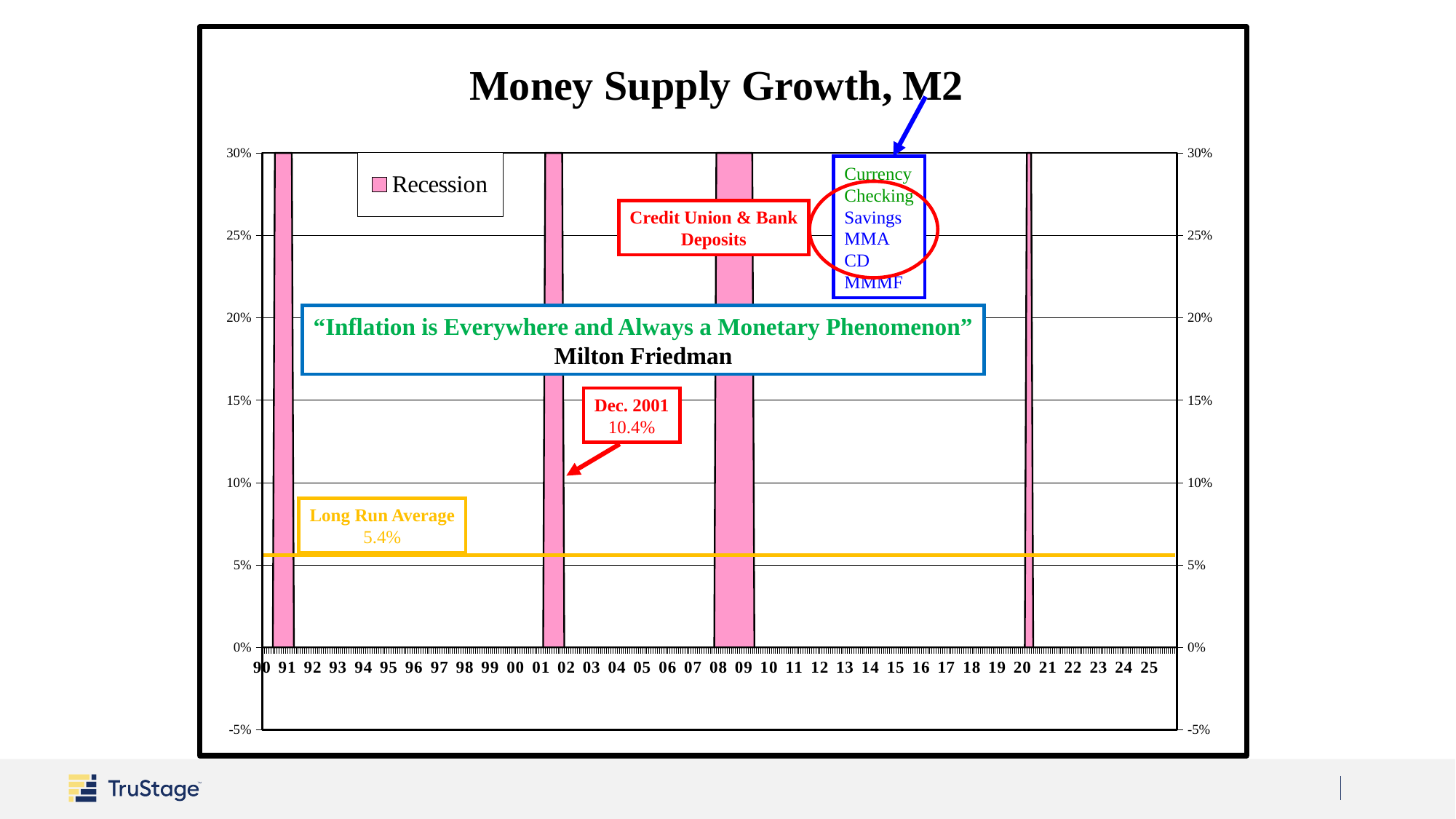
What value is annotated for Dec. 2001 on the chart? 10.4% What is the title of the chart? Money Supply Growth, M2 What is the only entry listed in the chart's legend? Recession Is the long run average line greater or less than 5%? greater What is the long run average value shown on the chart? 5.4% Is the long run average line greater or less than 10%? less Which is larger, the Dec. 2001 value or the long run average? Dec. 2001 What is the highest value shown on the y axis? 30% How many series does the legend list? 1 What is the lowest value shown on the y axis? -5% How many year labels are shown along the x axis? 36 How many recession bars are shaded on the chart? 4